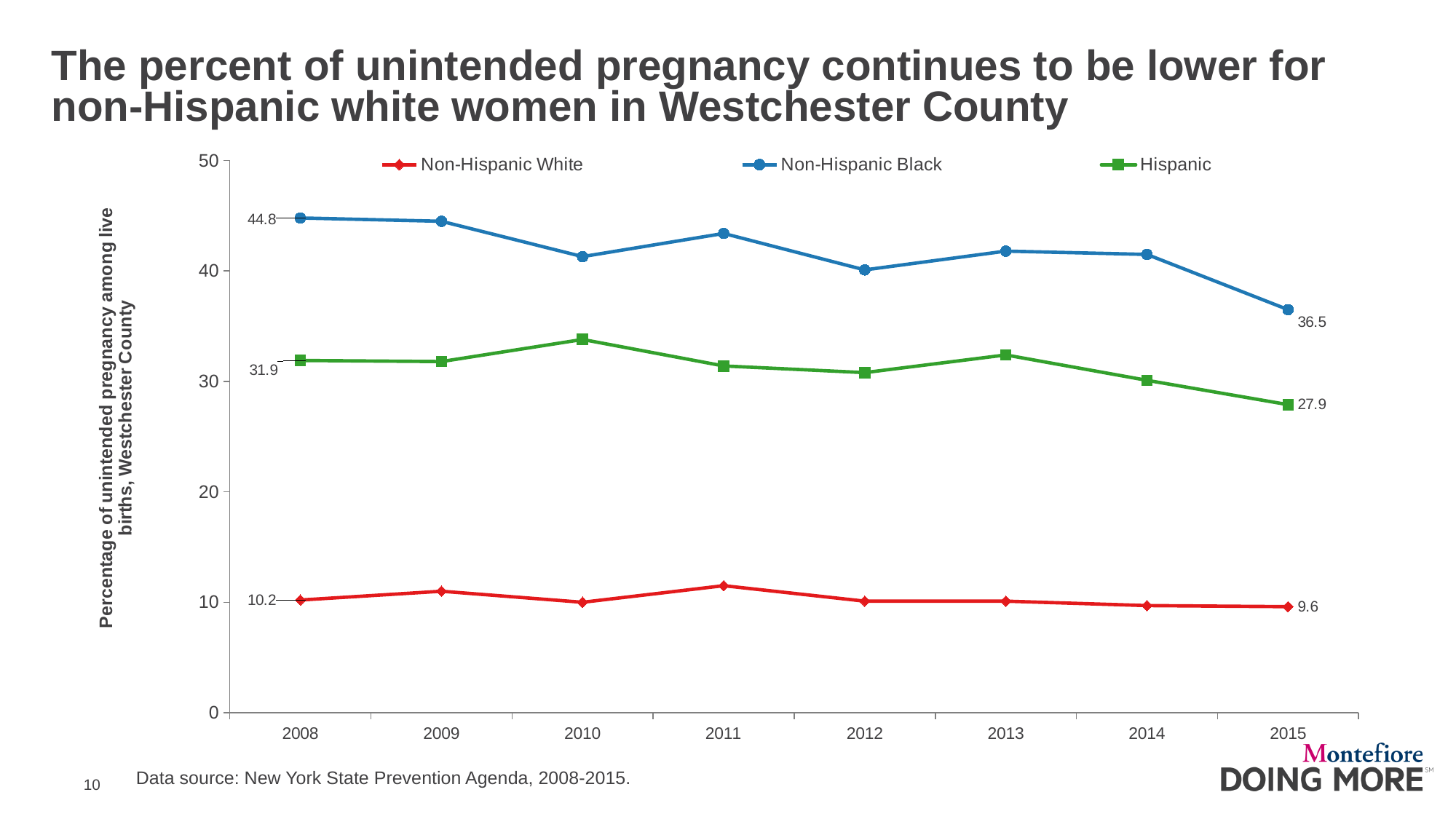
What is the value for Non-Hispanic Black in 2008? 44.8 What kind of chart is shown on the slide? Line chart Which series has the lowest value in 2008? Non-Hispanic White Does the Non-Hispanic Black series rise or fall from 2008 to 2015? Fall What is the value for Hispanic in 2015? 27.9 What is the difference between the Hispanic values in 2008 and 2015? 4.0 Which series has the highest value in 2015? Non-Hispanic Black What is the value for Non-Hispanic White in 2008? 10.2 What is the value for Non-Hispanic Black in 2015? 36.5 How many series does the legend list? 3 What is the difference between the Non-Hispanic Black values in 2008 and 2015? 8.3 Is the value for Non-Hispanic Black in 2012 greater or less than 30? greater